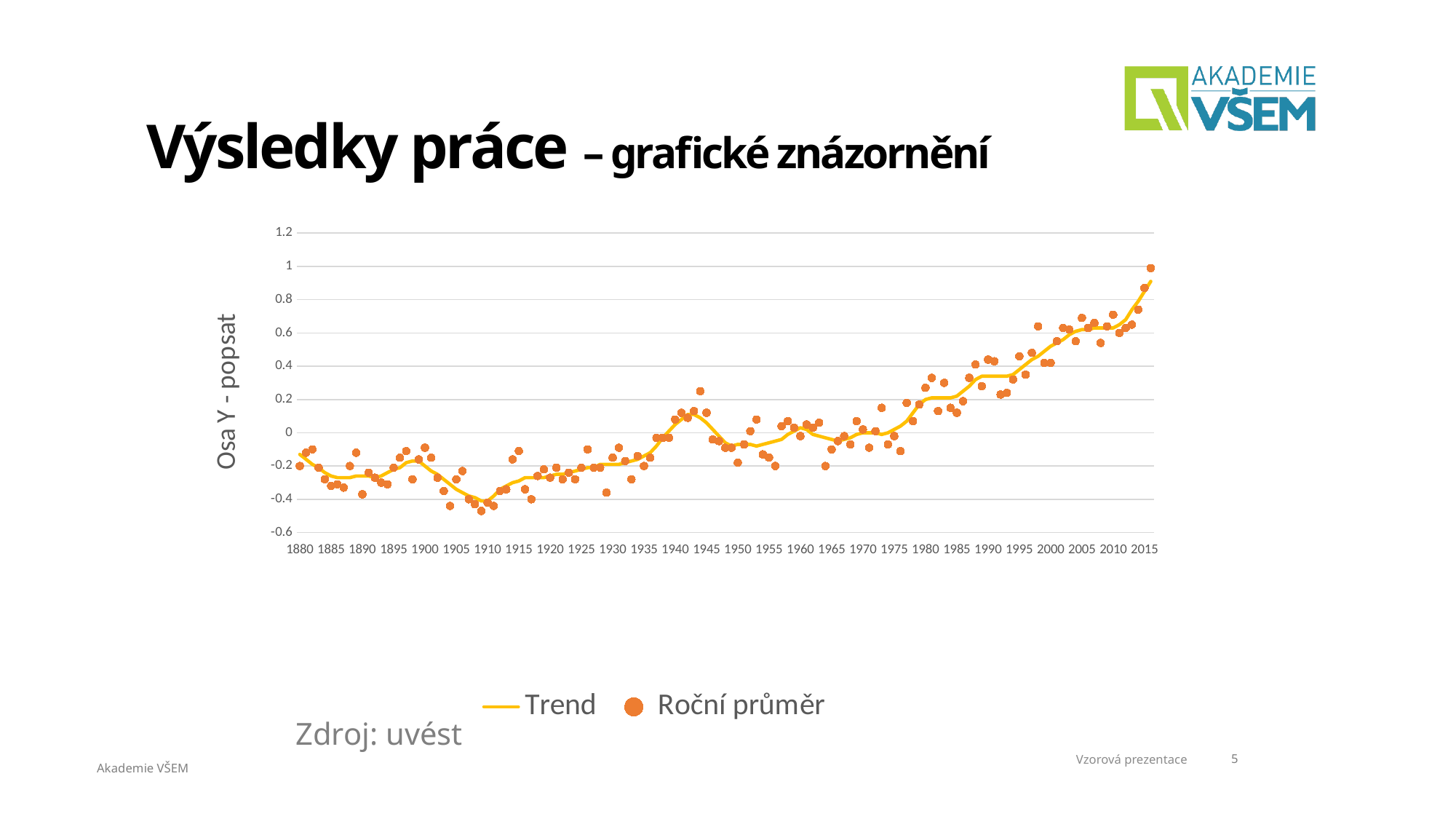
Do the values generally rise or fall from 1880 to 2015? Rise What kind of chart is shown on the slide? Scatter chart with a trend line How many series does the chart legend list? 2 Which year has the larger value, 1910 or 2010? 2010 Is the value for 1965 greater or less than 0.4? less Is the value for 2015 greater or less than 0.6? greater What is the label of the vertical axis? Osa Y - popsat What are the two entries in the chart legend? Trend, Roční průměr Is the value for 1880 greater or less than 0? less Which year has the larger value, 1905 or 1945? 1945